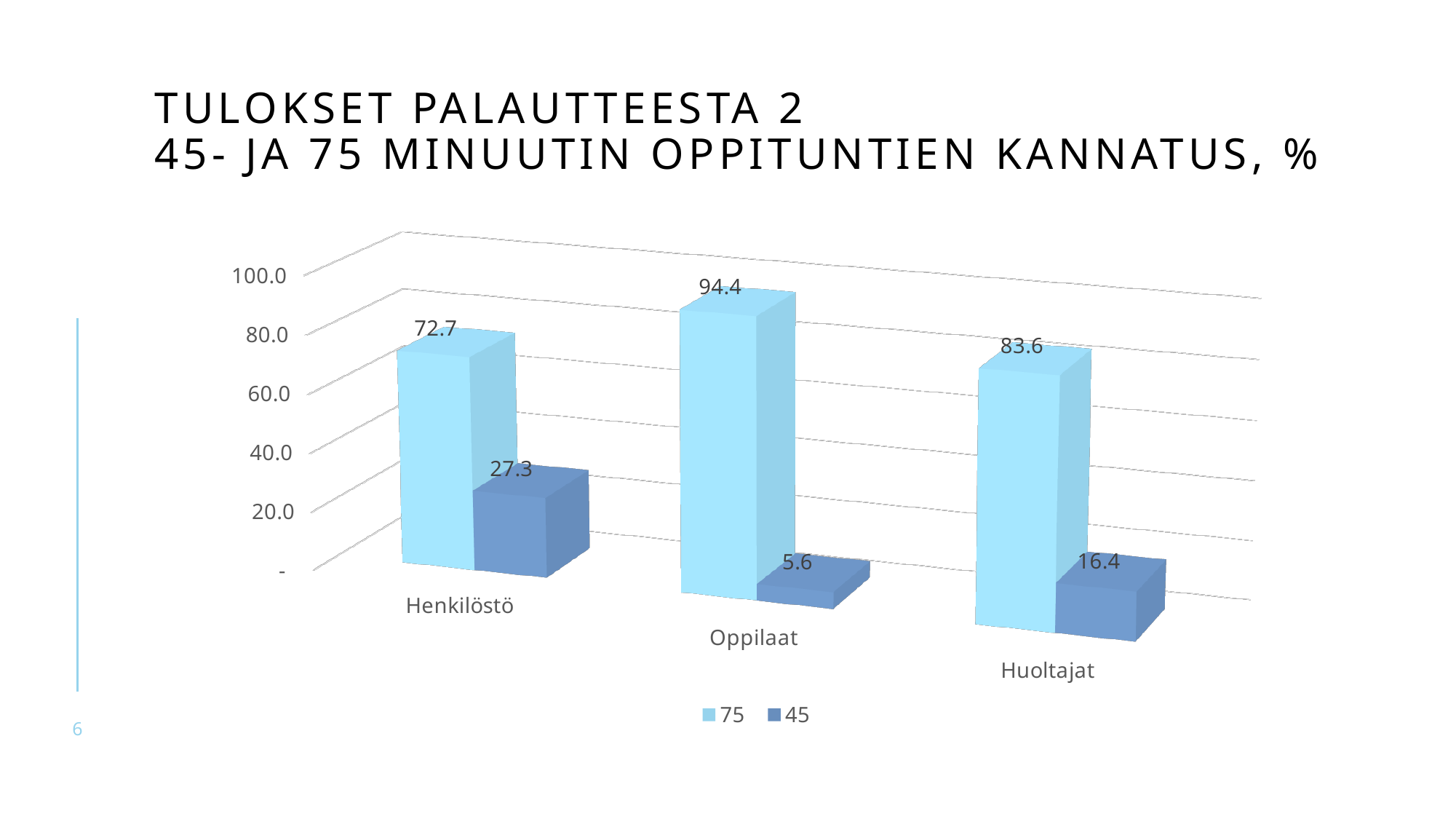
What is the difference between the 75 and 45 values for Henkilöstö? 45.4 What is the value for the 45 series for Huoltajat? 16.4 What kind of chart is shown on the slide? bar chart How many series does the legend list? 2 Which category has the lowest value for the 45 series? Oppilaat Which category has the highest value for the 75 series? Oppilaat What is the value for the 75 series for Oppilaat? 94.4 What is the value for the 45 series for Henkilöstö? 27.3 Is the 75 value for Huoltajat greater or less than 80.0? greater How many categories are shown on the x axis? 3 What is the difference between the 75 values for Oppilaat and Huoltajat? 10.8 Which is larger: the 45 value for Henkilöstö or the 45 value for Huoltajat? Henkilöstö